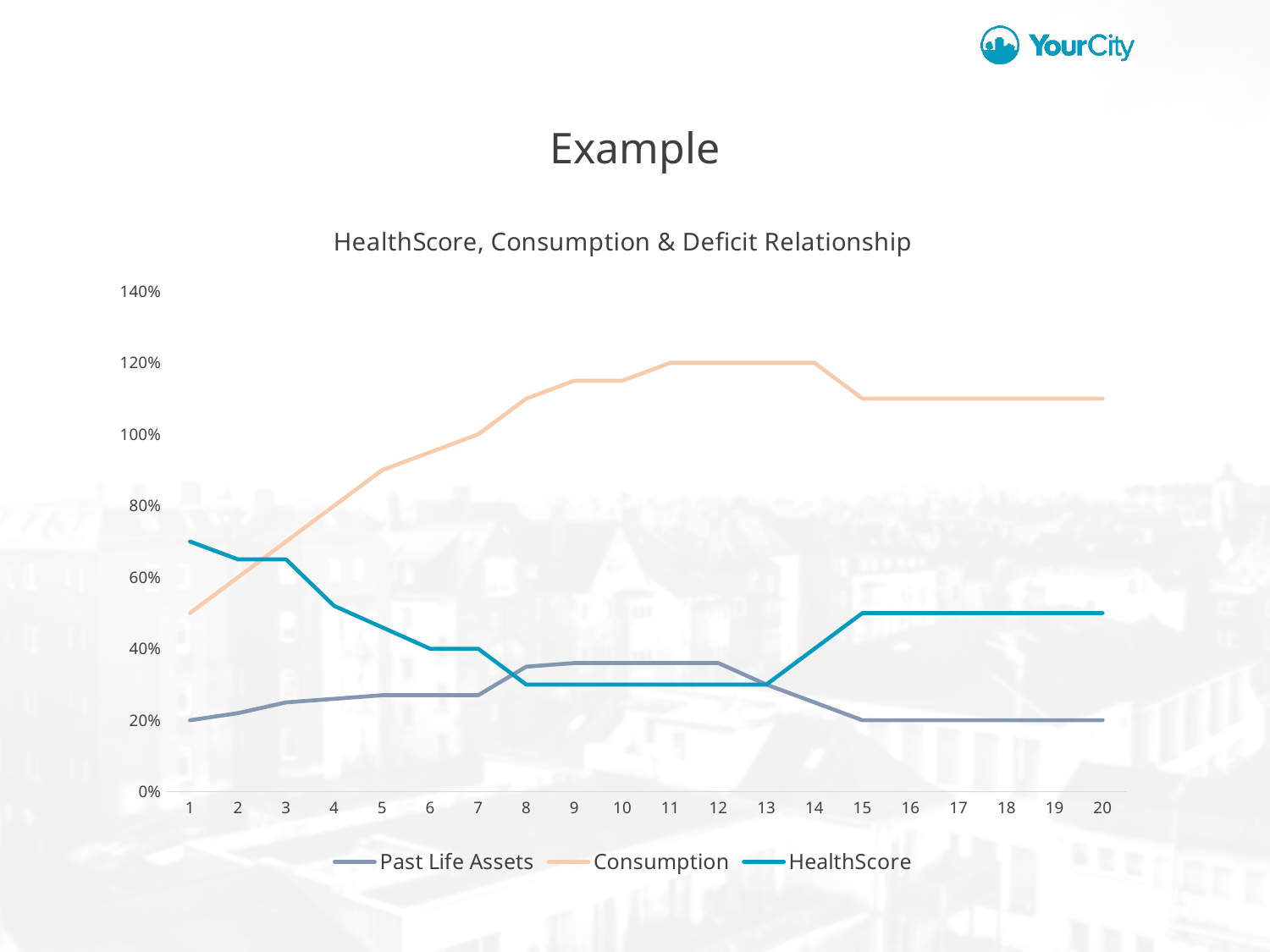
Which series has the highest value at point 10? Consumption How many series does the legend list? 3 Is the value for Consumption at point 20 greater or less than 100%? greater What is the value of HealthScore at point 6? 40% What is the title of the chart? HealthScore, Consumption & Deficit Relationship How many points are on the x axis? 20 At point 20, which is larger: Consumption or HealthScore? Consumption What kind of chart is shown on the slide? line chart What is the value of Consumption at point 11? 120% What is the value of Past Life Assets at point 1? 20% Is the value for HealthScore at point 1 greater or less than 60%? greater Does the HealthScore series rise or fall from point 1 to point 8? fall